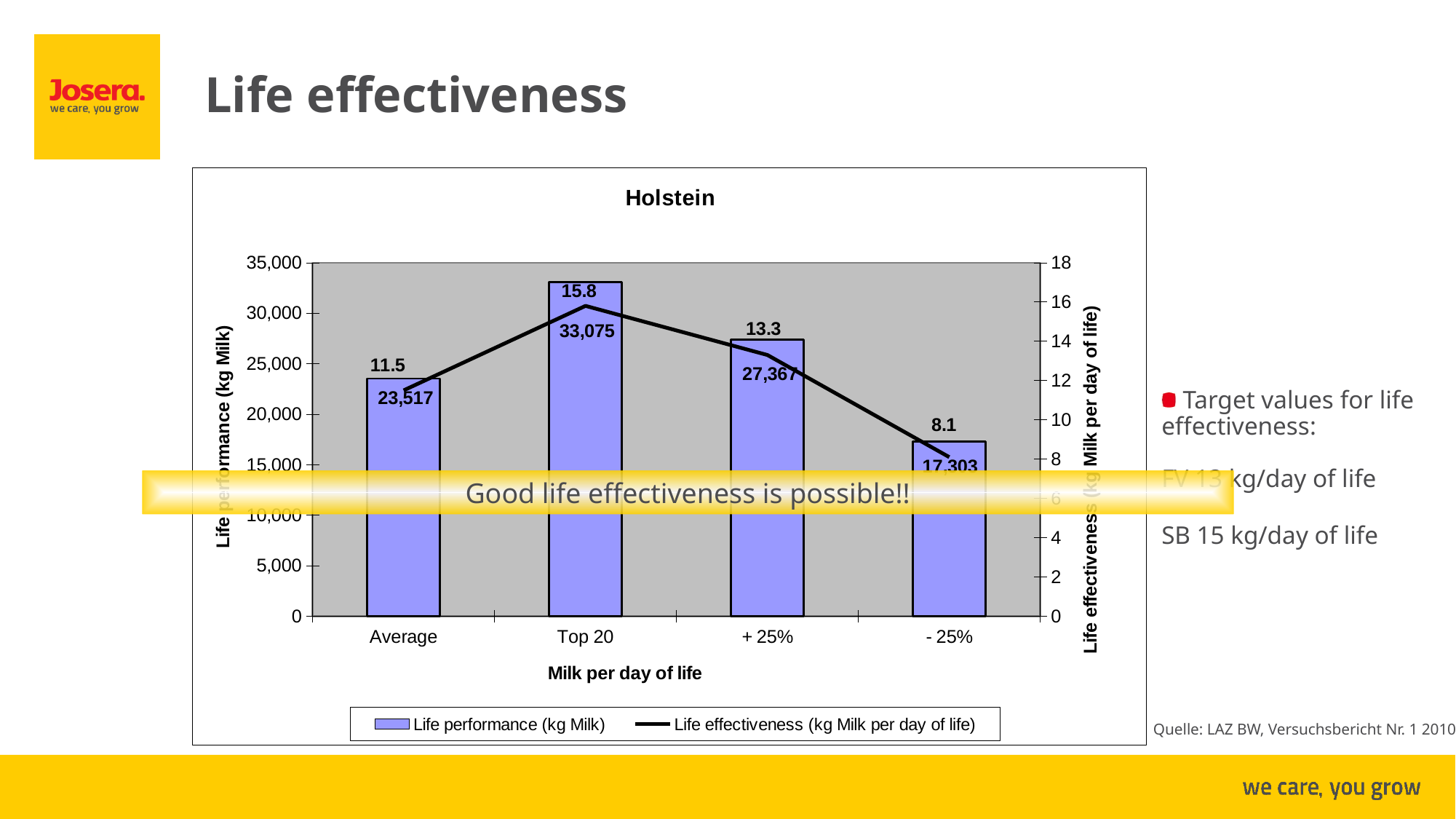
Which category has the highest Life performance (kg Milk)? Top 20 Is the Life performance (kg Milk) value for - 25% greater or less than 20,000? less What is the Life performance (kg Milk) value for Top 20? 33,075 What is the Life effectiveness (kg Milk per day of life) value for - 25%? 8.1 What is the title of the chart? Holstein Which has a higher Life effectiveness value, + 25% or Average? + 25% What is the Life effectiveness (kg Milk per day of life) value for Average? 11.5 Which category has the lowest Life effectiveness (kg Milk per day of life)? - 25% What is the difference in Life performance (kg Milk) between Top 20 and Average? 9,558 How many series does the legend list? 2 How many categories are shown on the x axis? 4 What is the Life performance (kg Milk) value for + 25%? 27,367